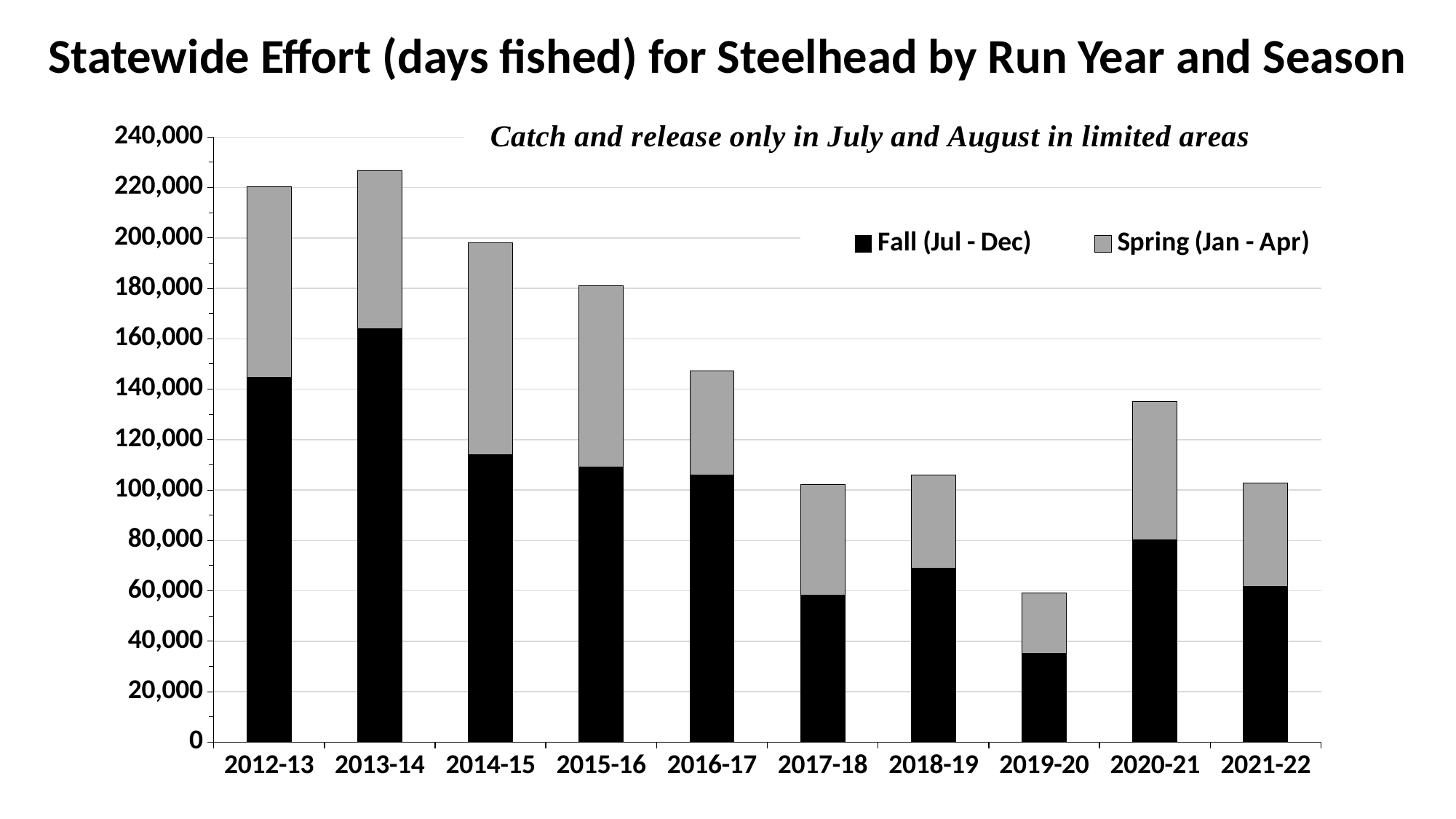
How many run years are shown on the x axis? 10 Which run year has the highest total days fished? 2013-14 What note is written in italics above the bars? Catch and release only in July and August in limited areas Which has the larger total effort, 2020-21 or 2021-22? 2020-21 Is the Fall (Jul - Dec) effort for 2020-21 greater or less than 100,000? less What kind of chart is shown on the slide? Stacked bar chart Is the total effort for 2012-13 greater or less than 200,000? greater Is the total effort for 2019-20 greater or less than 80,000? less Which run year has the lowest total days fished? 2019-20 Which run year has the highest Fall (Jul - Dec) effort? 2013-14 How many series does the legend list? 2